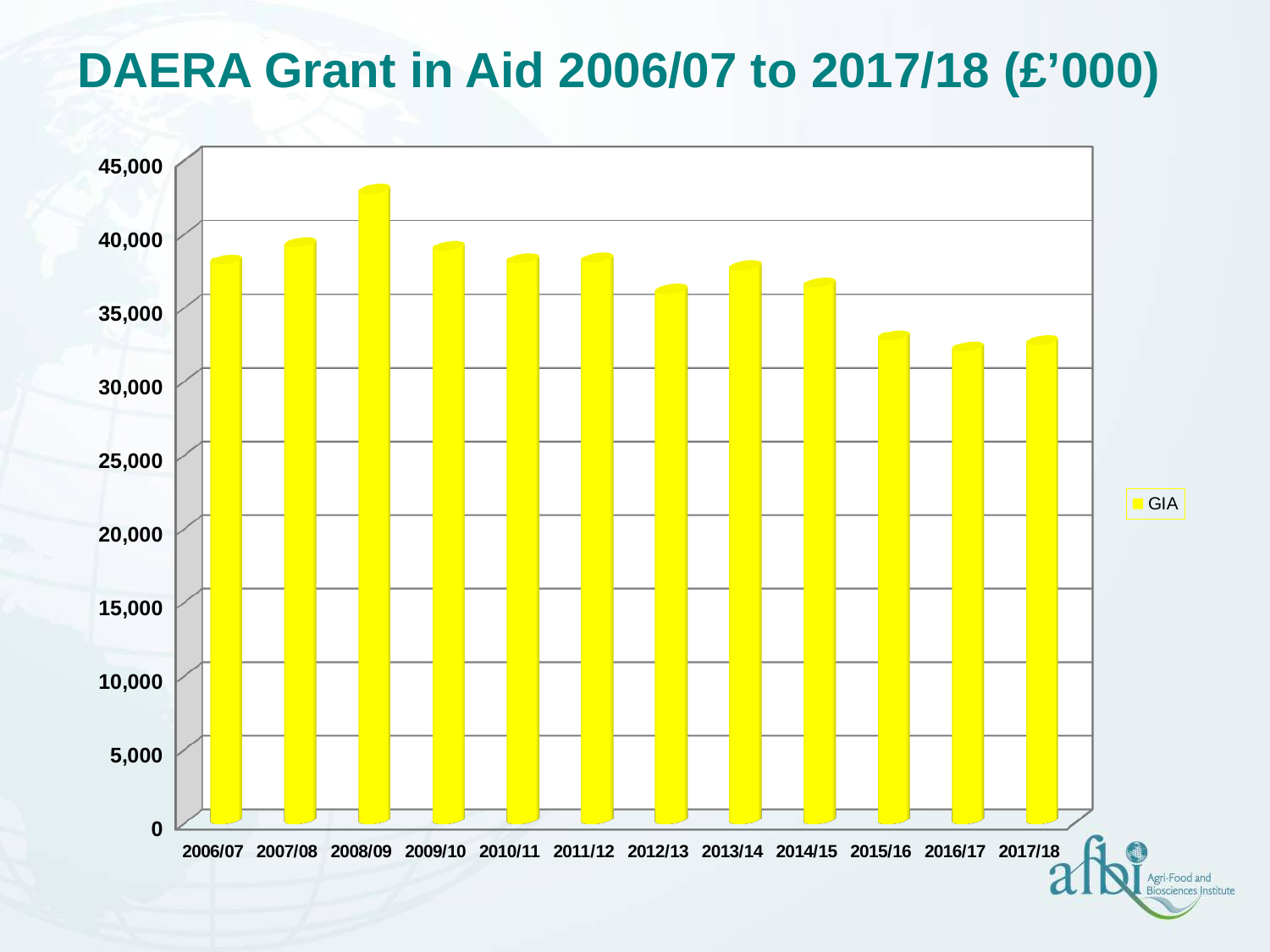
Which financial year has the highest Grant in Aid value? 2008/09 Is the value for 2008/09 greater or less than 40,000? greater What kind of chart is shown on the slide? bar chart Is the value for 2006/07 greater or less than 35,000? greater How many financial years are shown on the x axis of the chart? 12 Is the value for 2015/16 greater or less than 35,000? less Which is larger, the value for 2007/08 or the value for 2017/18? 2007/08 What is the name of the series shown in the chart's legend? GIA How many series does the chart's legend list? 1 Which is larger, the value for 2008/09 or the value for 2015/16? 2008/09 Overall, do the Grant in Aid values rise or fall from 2008/09 to 2017/18? fall